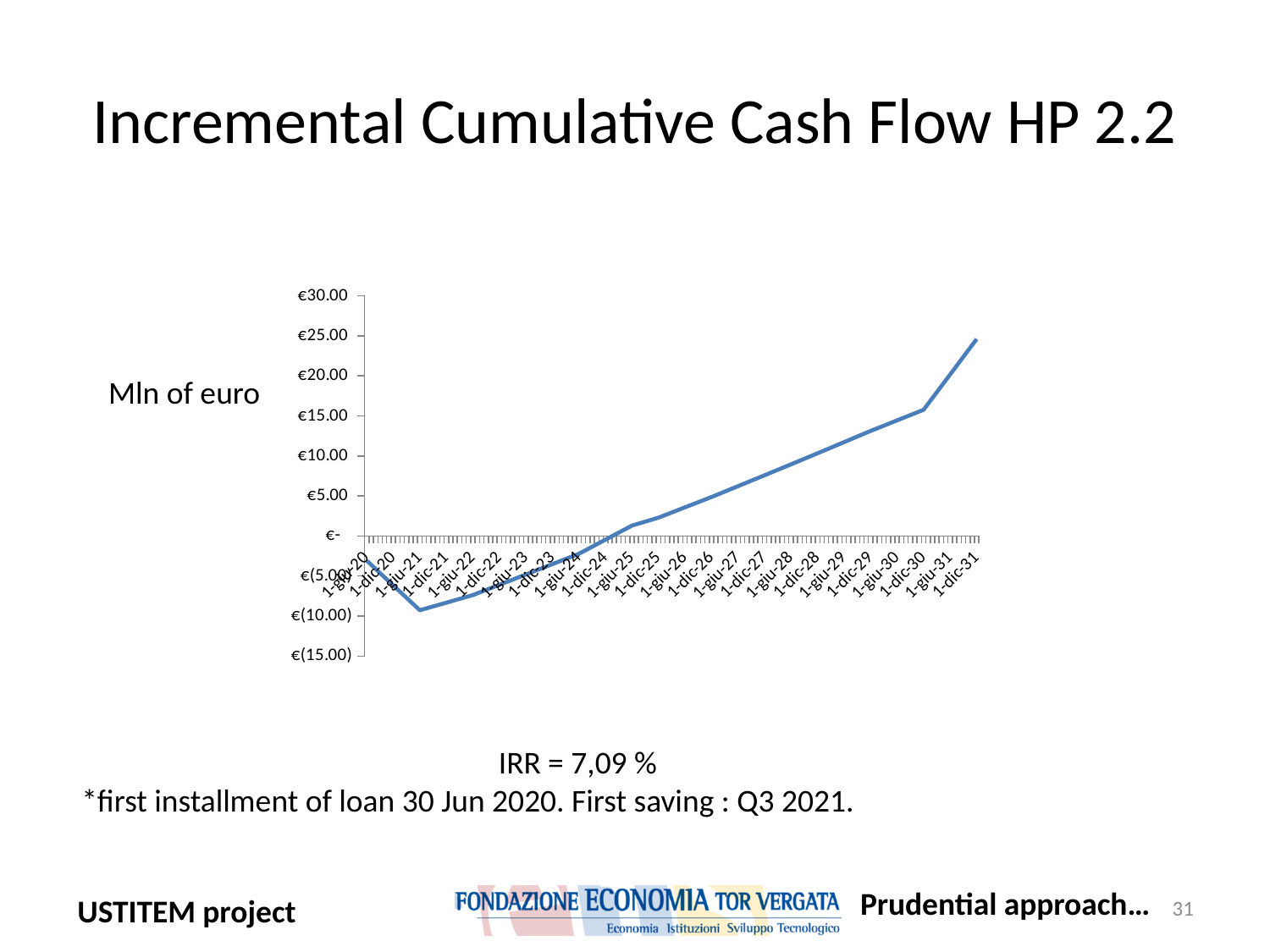
Which is larger, the value at 1-dic-31 or the value at 1-giu-21? 1-dic-31 Is the value at 1-giu-21 greater or less than €(5.00)? less What is the title of the chart on the slide? Incremental Cumulative Cash Flow HP 2.2 Is the value at 1-dic-25 greater or less than €5.00? less At which date does the line reach its lowest value? 1-giu-21 What kind of chart is shown on the slide? line chart In what unit are the values on the chart expressed, according to the label next to the y axis? Mln of euro Is the value at 1-giu-29 greater or less than €10.00? greater From 1-giu-21 to 1-dic-31, does the line rise or fall? rise At which date does the line reach its highest value? 1-dic-31